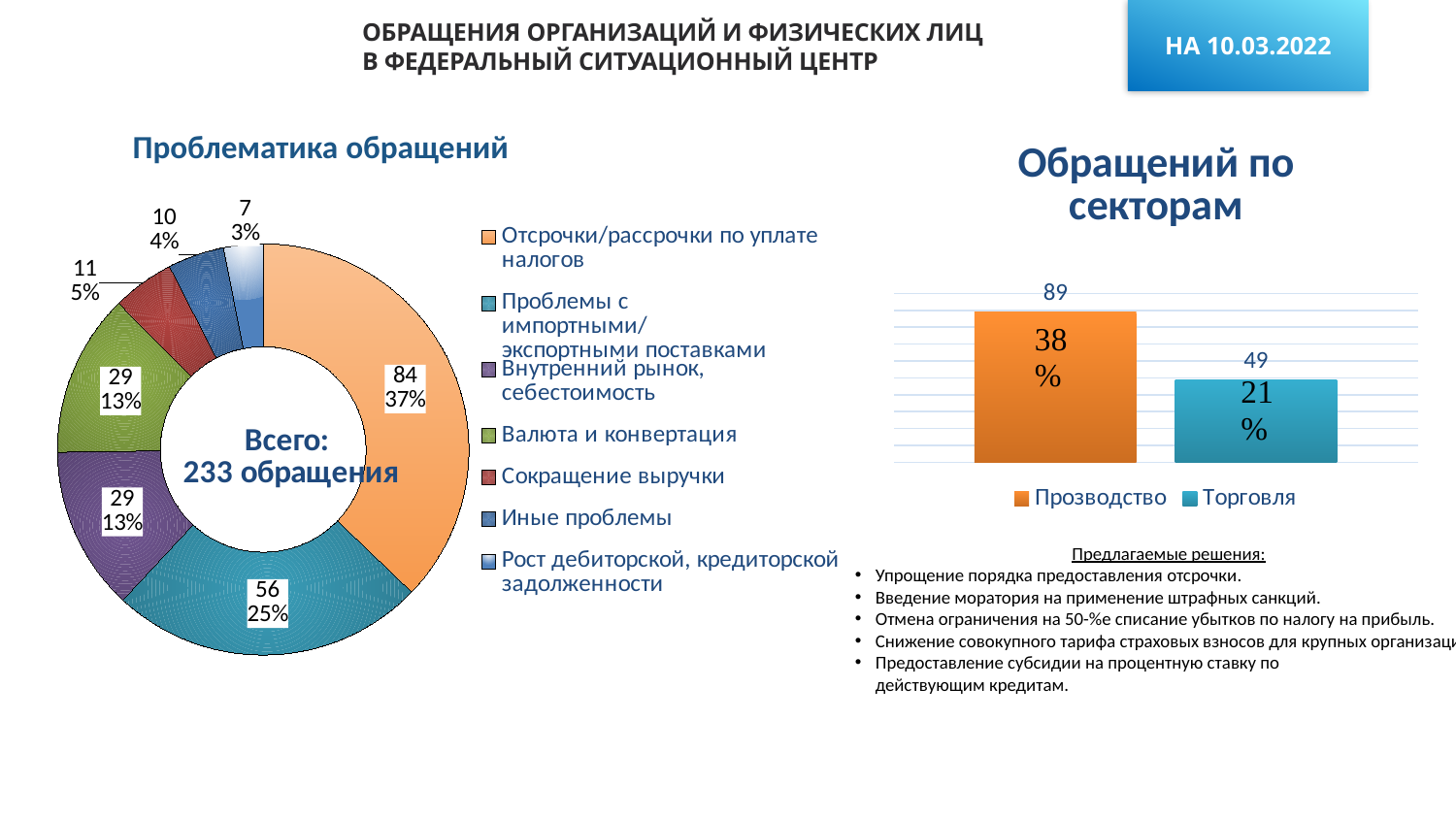
In the 'Проблематика обращений' chart, how many appeals relate to 'Отсрочки/рассрочки по уплате налогов'? 84 What type of chart is 'Проблематика обращений'? Doughnut chart In the 'Проблематика обращений' chart, what is the difference between the number of appeals for 'Отсрочки/рассрочки по уплате налогов' and 'Проблемы с импортными/экспортными поставками'? 28 In the 'Обращений по секторам' chart, what is the difference between 'Прозводство' and 'Торговля'? 40 In the 'Проблематика обращений' chart, how many categories are shown in the legend? 7 In the 'Проблематика обращений' chart, what share of appeals is 'Проблемы с импортными/экспортными поставками'? 25% In the 'Обращений по секторам' chart, what percentage is shown on the 'Торговля' bar? 21% In the 'Обращений по секторам' chart, what is the value for 'Прозводство'? 89 How many series does the legend of the 'Обращений по секторам' chart list? 2 In the 'Проблематика обращений' chart, which category has the smallest number of appeals? Рост дебиторской, кредиторской задолженности In the 'Проблематика обращений' chart, what total number of appeals is stated in the centre? 233 обращения In the 'Проблематика обращений' chart, which category has the largest number of appeals? Отсрочки/рассрочки по уплате налогов